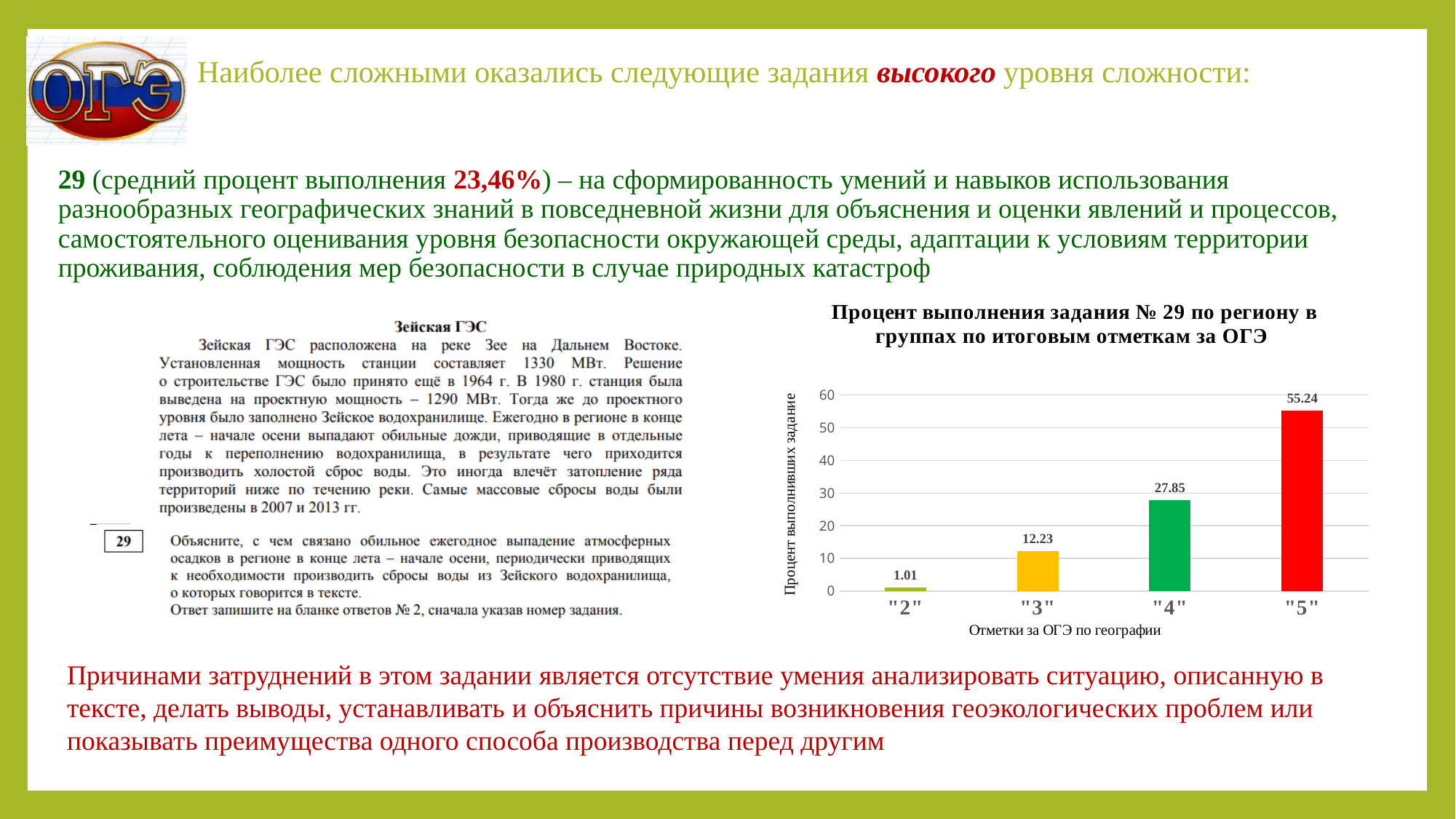
Which group has the lowest value in the chart? "2" What is the difference between the values for the "5" and "4" groups? 27.39 What is the value for the "4" group in the chart? 27.85 What is the value for the "5" group in the chart? 55.24 How many groups (bars) are shown in the chart? 4 What type of chart is shown on the slide? Bar chart Which is larger, the value for the "3" group or the "4" group? "4" What is the value for the "2" group in the chart? 1.01 What is the value for the "3" group in the chart? 12.23 Do the values rise or fall from the "2" group to the "5" group? Rise What is the label of the x axis of the chart? Отметки за ОГЭ по географии Which group has the highest value in the chart? "5"